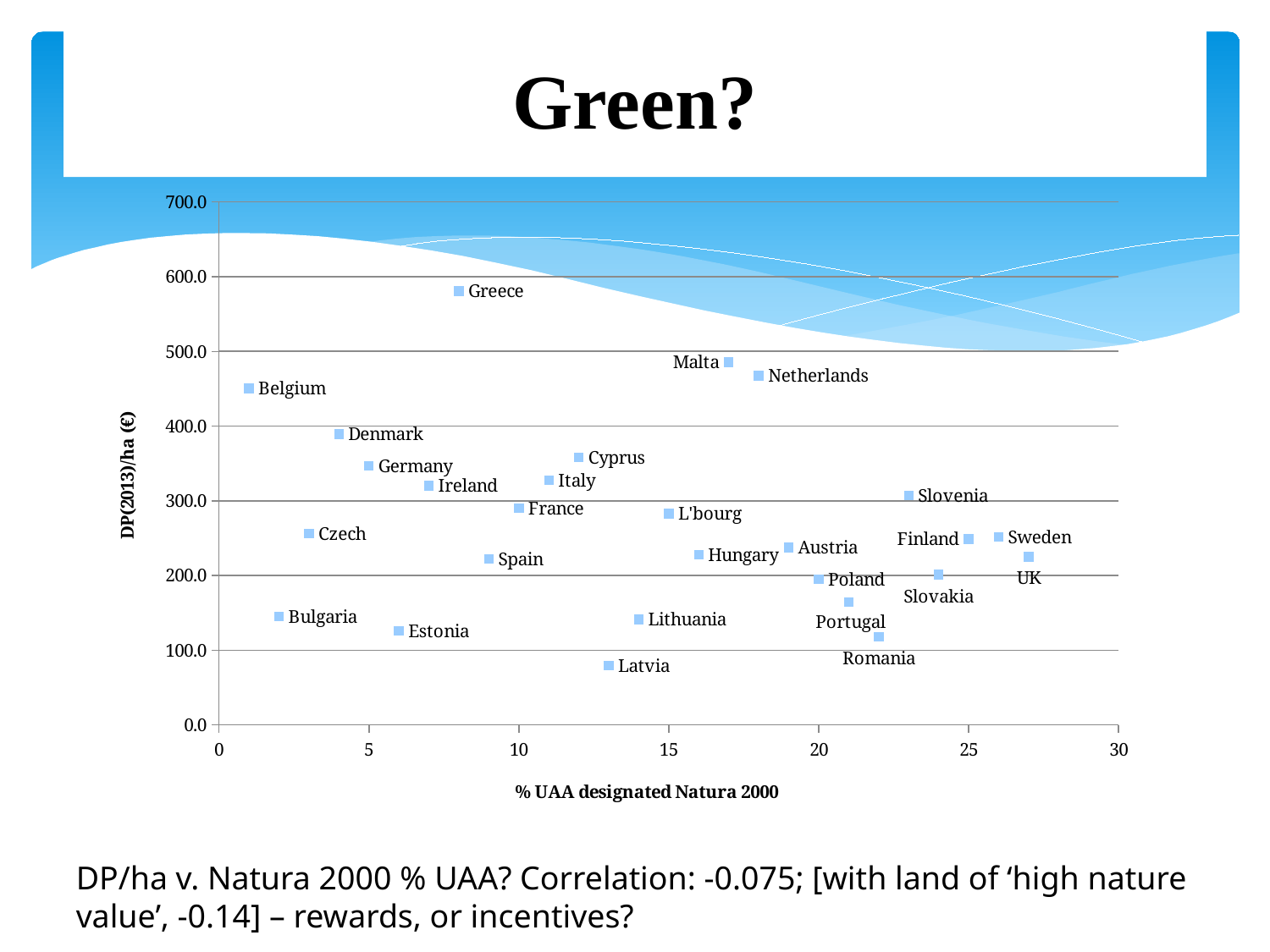
What is the label of the x axis? % UAA designated Natura 2000 Which country has the lowest DP(2013)/ha value? Latvia Is the % UAA designated Natura 2000 for Sweden greater or less than 25? greater Which has a higher DP(2013)/ha value, Greece or Belgium? Greece What kind of chart is shown on the slide? scatter chart Is the DP(2013)/ha value for Latvia greater or less than 100? less Which has a higher % UAA designated Natura 2000, UK or Belgium? UK Is the DP(2013)/ha value for Belgium greater or less than 400? greater What is the label of the y axis? DP(2013)/ha (€) Which country has the highest DP(2013)/ha value? Greece